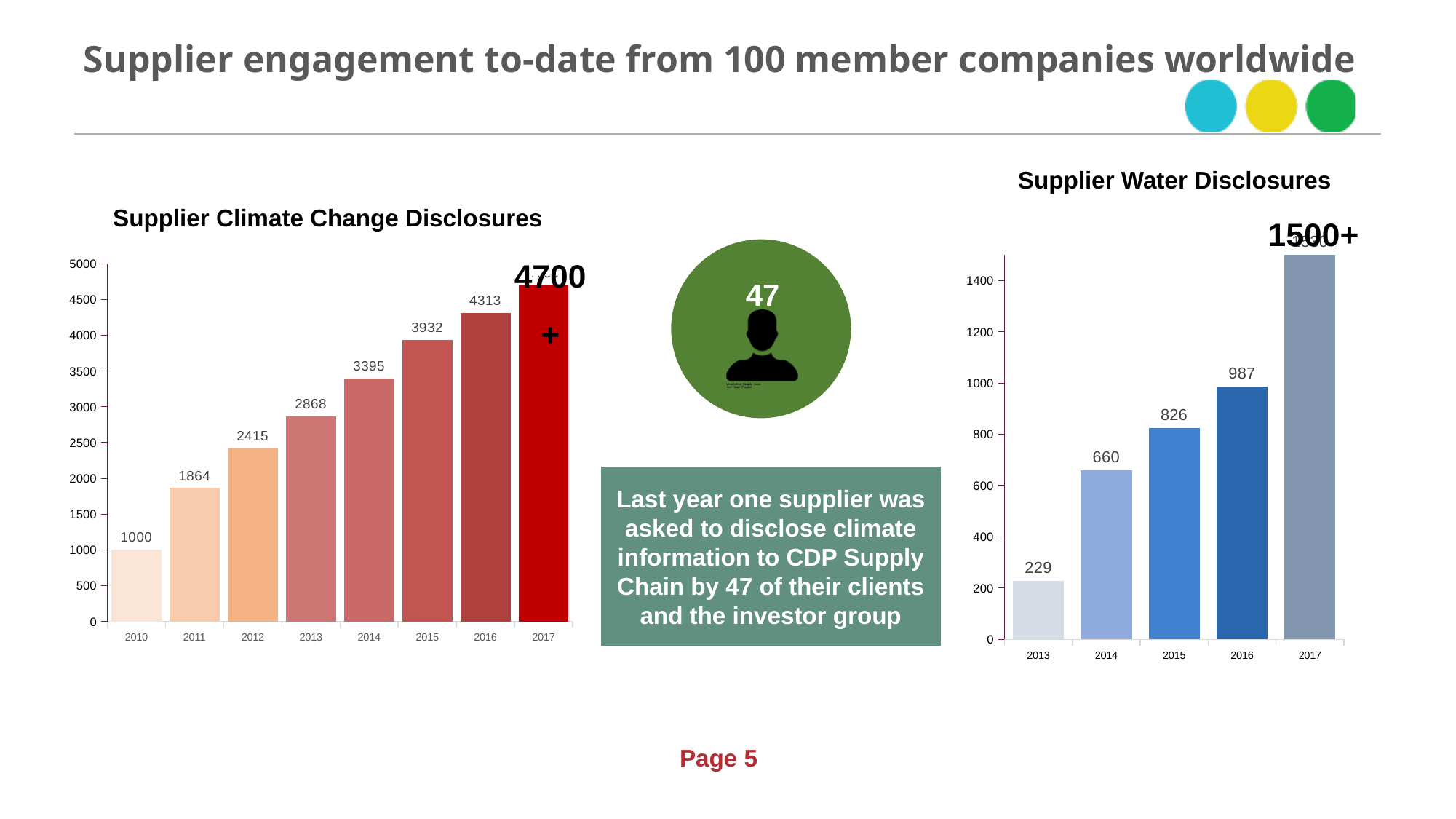
In the Supplier Water Disclosures chart, what is the difference between the values for 2014 and 2013? 431 In the Supplier Climate Change Disclosures chart, do the values rise or fall from 2010 to 2017? rise In the Supplier Climate Change Disclosures chart, what is the difference between the values for 2016 and 2015? 381 In the Supplier Water Disclosures chart, is the value for 2017 greater or less than 1400? greater In the Supplier Water Disclosures chart, which year has the lowest value? 2013 How many years are shown on the x axis of the Supplier Water Disclosures chart? 5 In the Supplier Climate Change Disclosures chart, which year has the highest value? 2017 In the Supplier Climate Change Disclosures chart, which is larger, the value for 2012 or the value for 2014? 2014 In the Supplier Climate Change Disclosures chart, what is the value for 2013? 2868 How many years are shown on the x axis of the Supplier Climate Change Disclosures chart? 8 In the Supplier Climate Change Disclosures chart, what is the value for 2010? 1000 In the Supplier Water Disclosures chart, what is the value for 2015? 826